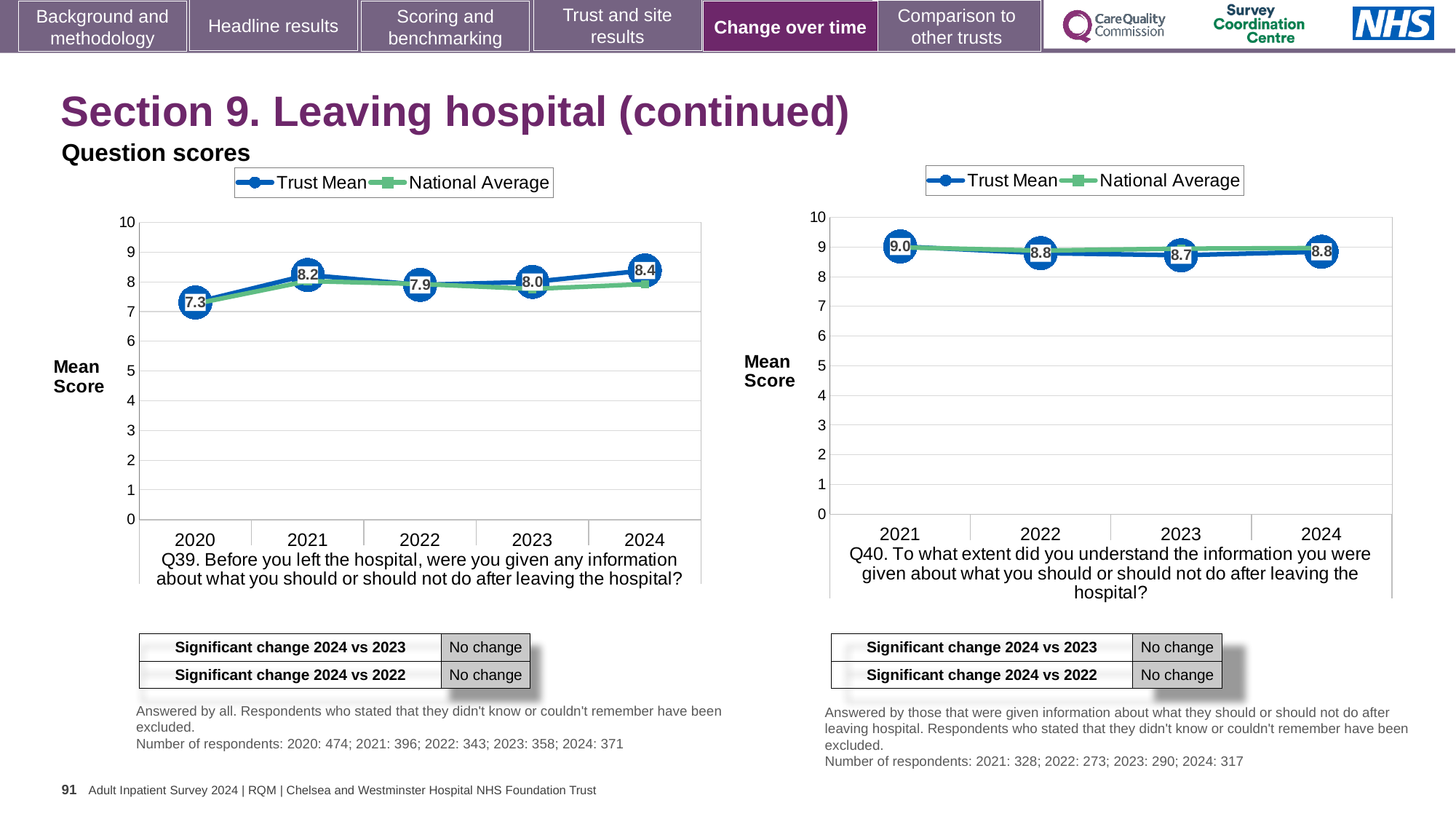
In the Q39 chart on the left, what is the Trust Mean score for 2020? 7.3 How many series does the legend of the Q40 chart on the right list? 2 In the Q40 chart on the right, what is the Trust Mean score for 2023? 8.7 In the Q40 chart on the right, does the Trust Mean score rise or fall from 2021 to 2023? Fall In the Q39 chart on the left, is the National Average value for 2020 greater or less than 8? less How many years are plotted on the x axis of the Q39 chart on the left? 5 In the Q39 chart on the left, what is the difference between the Trust Mean scores for 2024 and 2020? 1.1 In the Q39 chart on the left, is the Trust Mean score higher in 2021 or in 2022? 2021 What type of chart is the Q39 chart on the left? Line chart In the Q40 chart on the right, is the National Average value for 2024 greater or less than 8? greater In the Q40 chart on the right, which year has the lowest Trust Mean score? 2023 In the Q39 chart on the left, which year has the highest Trust Mean score? 2024